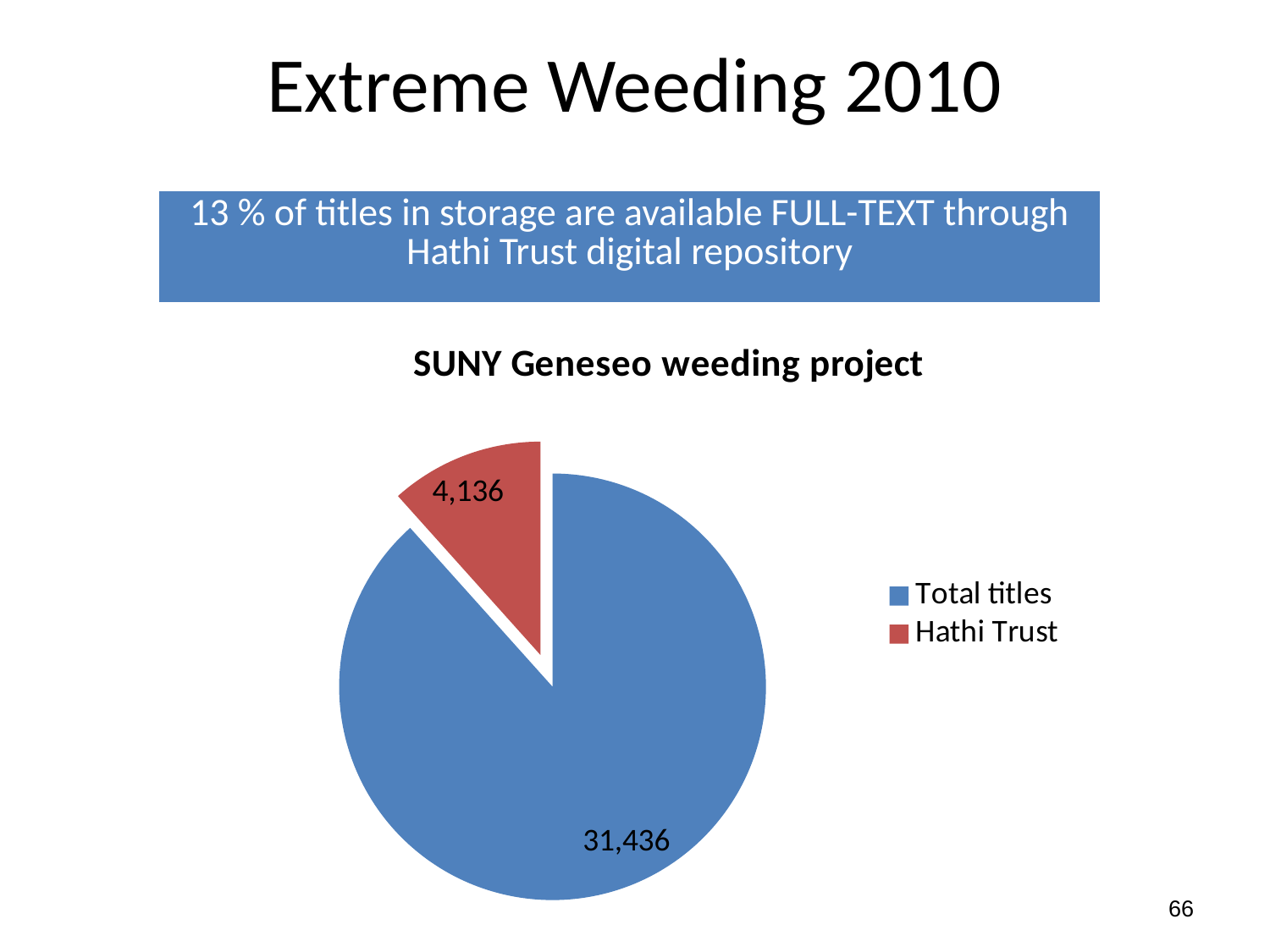
How many slices does the pie chart have? 2 What type of chart is shown on the slide? Pie chart What is the title of the chart? SUNY Geneseo weeding project Which slice of the pie is the smallest? Hathi Trust What is the difference between the Total titles value and the Hathi Trust value? 27,300 Which slice of the pie is the largest? Total titles What is the value shown for the Total titles slice? 31,436 How many entries does the legend list? 2 What colour is the Hathi Trust slice? Red What is the value shown for the Hathi Trust slice? 4,136 Which is larger, the Total titles slice or the Hathi Trust slice? Total titles